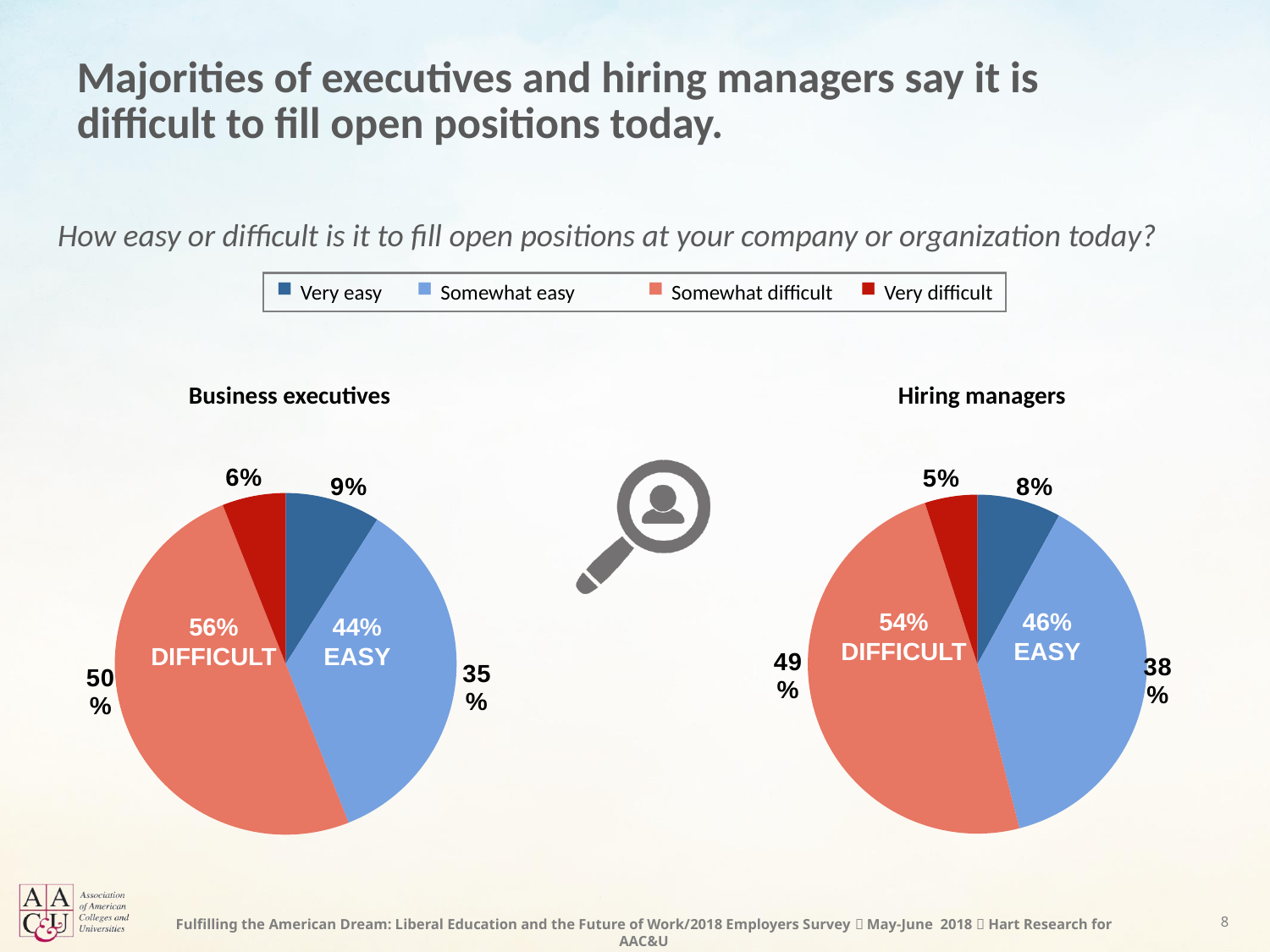
In the Business executives pie chart, which response category has the largest share? Somewhat difficult In the Hiring managers pie chart, what percentage say it is very difficult to fill open positions? 5% In the Business executives pie chart, what percentage of respondents say it is somewhat difficult to fill open positions? 50% In the Business executives pie chart, what percentage say it is very easy to fill open positions? 9% Is the somewhat easy share larger for Business executives or for Hiring managers? Hiring managers In the Hiring managers pie chart, which response category has the smallest share? Very difficult How many categories does the legend list? 4 In the Hiring managers pie chart, what is the combined share of the somewhat difficult and very difficult slices? 54% In the Hiring managers pie chart, what percentage of respondents say it is somewhat easy to fill open positions? 38% What type of chart is used to show the Business executives results? Pie chart In the Business executives pie chart, what is the difference between the somewhat difficult share and the somewhat easy share? 15% How many slices does the Hiring managers pie chart have? 4